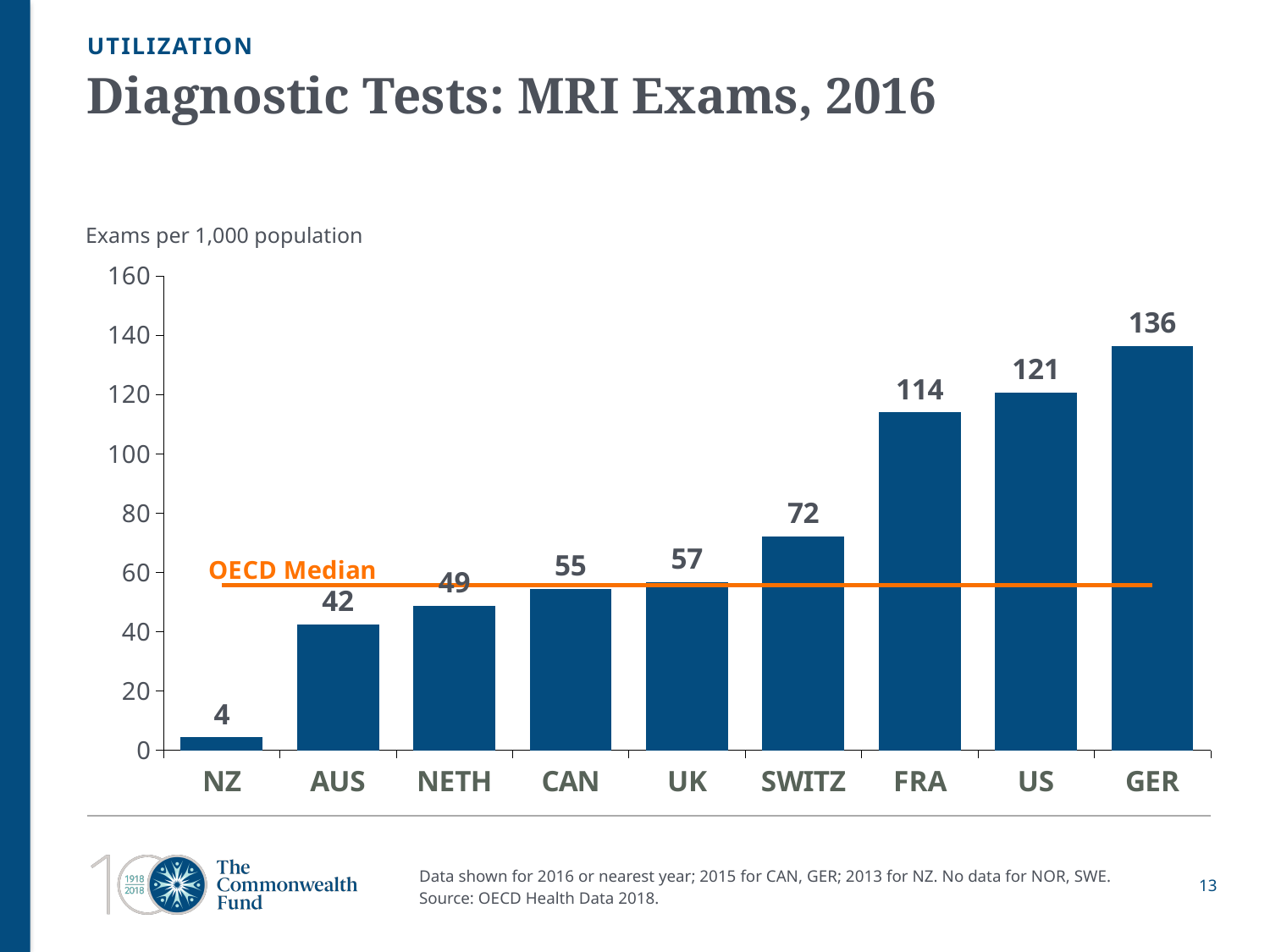
What is the value for NZ? 4 Which country has the highest number of MRI exams per 1,000 population? GER How many countries are shown on the chart? 9 Is the value for FRA greater or less than 100? greater What is the difference between the values for FRA and SWITZ? 42 What does the orange horizontal line on the chart represent? OECD Median What kind of chart is shown on the slide? Bar chart What is the value for the US? 121 What is the value for SWITZ? 72 Which country has the lowest number of MRI exams per 1,000 population? NZ Which has a higher value, CAN or UK? UK What is the difference between the values for GER and the US? 15